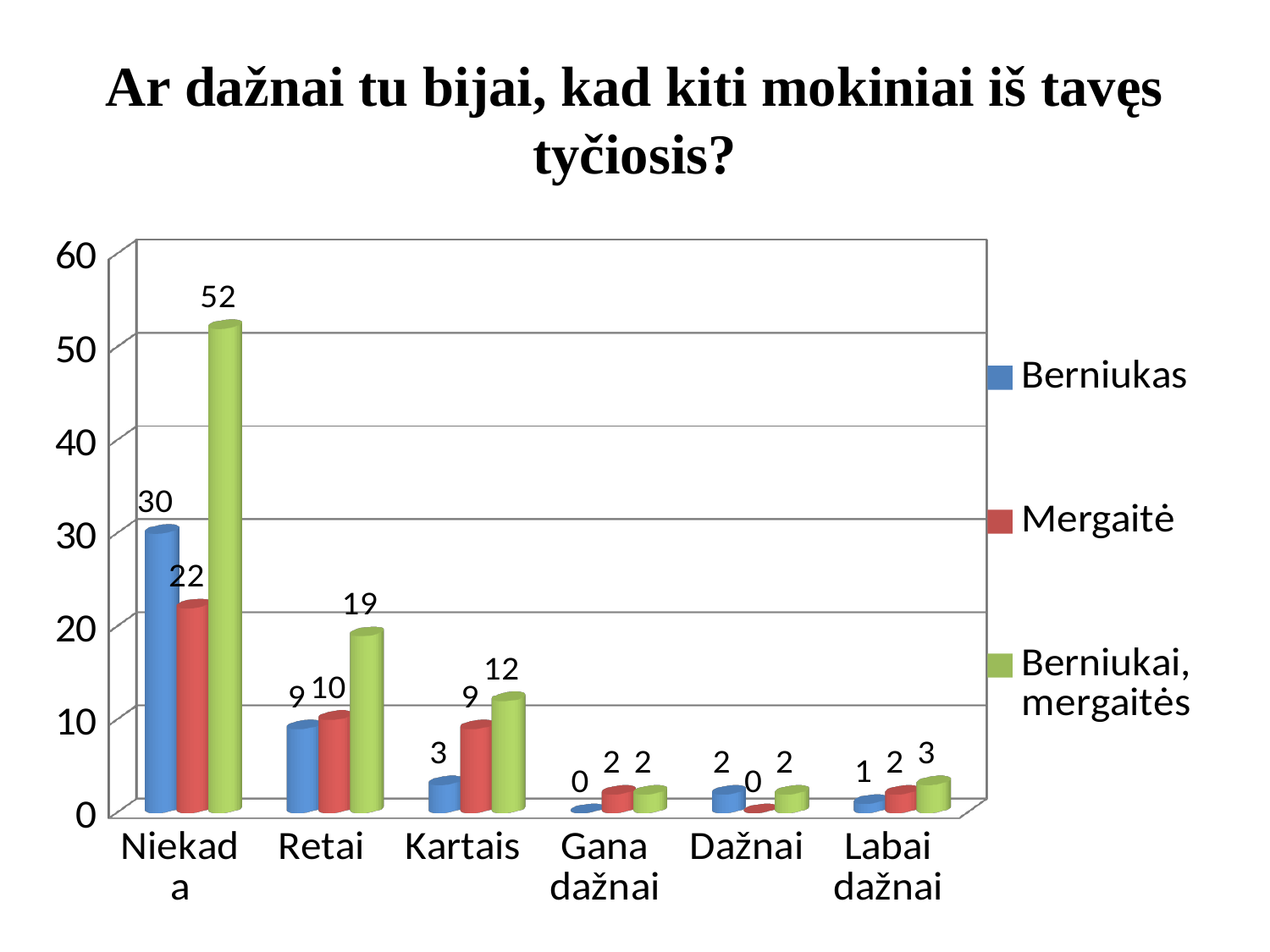
What is the value for Berniukas in the Niekada category? 30 What is the title of the chart? Ar dažnai tu bijai, kad kiti mokiniai iš tavęs tyčiosis? What is the value for Mergaitė in the Dažnai category? 0 Which category has the highest value for the Berniukai, mergaitės series? Niekada What is the value for Mergaitė in the Retai category? 10 How many categories are shown on the x axis? 6 What kind of chart is shown on the slide? bar chart What is the difference between the Berniukai, mergaitės value and the Berniukas value in the Niekada category? 22 Which is larger in the Kartais category: the Berniukas value or the Mergaitė value? Mergaitė Which category has the lowest value for the Berniukas series? Gana dažnai How many series does the legend list? 3 What is the value for Berniukai, mergaitės in the Kartais category? 12